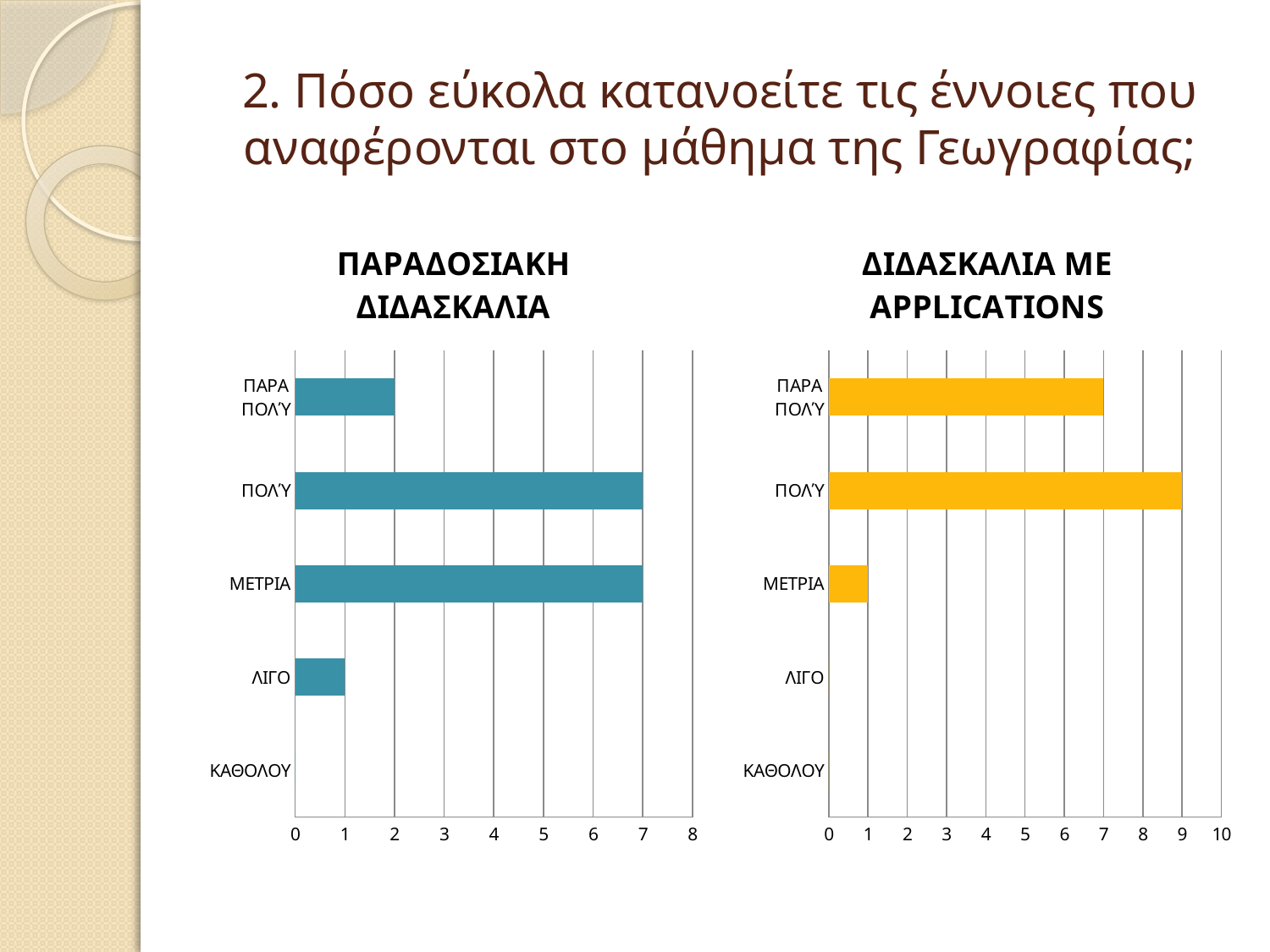
How many categories are shown in the ΠΑΡΑΔΟΣΙΑΚΗ ΔΙΔΑΣΚΑΛΙΑ chart? 5 In the ΠΑΡΑΔΟΣΙΑΚΗ ΔΙΔΑΣΚΑΛΙΑ chart, which category has the lowest value? ΚΑΘΟΛΟΥ Is the value for ΠΟΛΎ in the ΔΙΔΑΣΚΑΛΙΑ ΜΕ APPLICATIONS chart greater or less than 5? greater In the ΠΑΡΑΔΟΣΙΑΚΗ ΔΙΔΑΣΚΑΛΙΑ chart, which is larger, the value for ΠΑΡΑ ΠΟΛΎ or the value for ΛΙΓΟ? ΠΑΡΑ ΠΟΛΎ What is the title of the chart on the left of the slide? ΠΑΡΑΔΟΣΙΑΚΗ ΔΙΔΑΣΚΑΛΙΑ In the ΠΑΡΑΔΟΣΙΑΚΗ ΔΙΔΑΣΚΑΛΙΑ chart, what is the value for ΠΑΡΑ ΠΟΛΎ? 2 What kind of chart is the ΔΙΔΑΣΚΑΛΙΑ ΜΕ APPLICATIONS chart? Bar chart In the ΔΙΔΑΣΚΑΛΙΑ ΜΕ APPLICATIONS chart, what is the difference between the values for ΠΟΛΎ and ΜΕΤΡΙΑ? 8 In the ΔΙΔΑΣΚΑΛΙΑ ΜΕ APPLICATIONS chart, what is the value for ΠΑΡΑ ΠΟΛΎ? 7 In the ΠΑΡΑΔΟΣΙΑΚΗ ΔΙΔΑΣΚΑΛΙΑ chart, what is the value for ΛΙΓΟ? 1 In the ΔΙΔΑΣΚΑΛΙΑ ΜΕ APPLICATIONS chart, what is the value for ΠΟΛΎ? 9 In the ΔΙΔΑΣΚΑΛΙΑ ΜΕ APPLICATIONS chart, which category has the highest value? ΠΟΛΎ